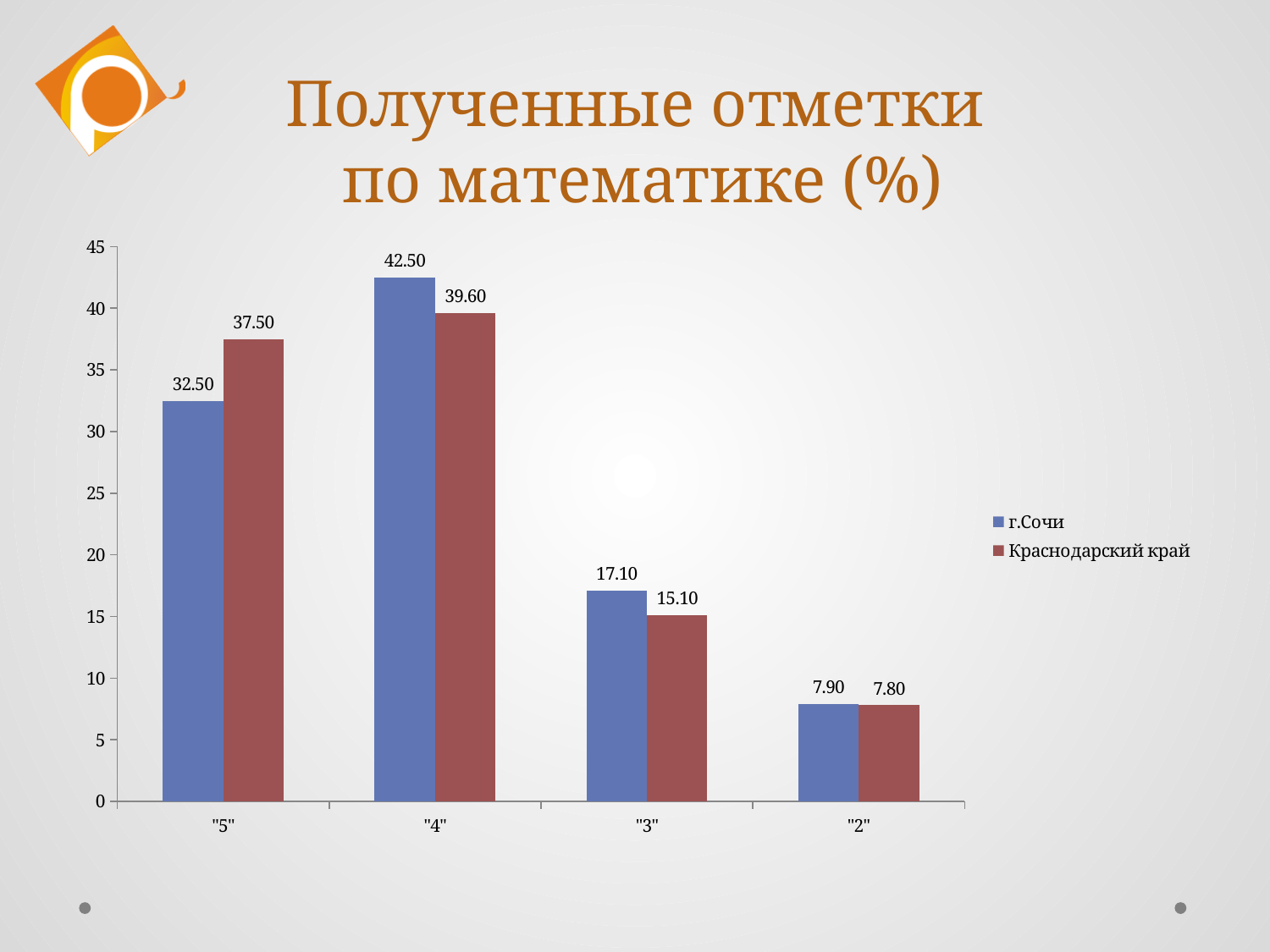
What kind of chart is shown on the slide? bar chart What is the difference between Краснодарский край and г.Сочи for the "5" category? 5.00 How many categories are shown on the x axis? 4 For the "3" category, which series has the larger value, г.Сочи or Краснодарский край? г.Сочи What is the value for г.Сочи for the "2" category? 7.90 What is the value for Краснодарский край for the "5" category? 37.50 Which category has the lowest value for г.Сочи? "2" What is the difference between г.Сочи and Краснодарский край for the "4" category? 2.90 Is the value for г.Сочи in the "5" category greater or less than 30? greater Which category has the highest value for Краснодарский край? "4" What is the value for г.Сочи for the "4" category? 42.50 How many series does the legend list? 2